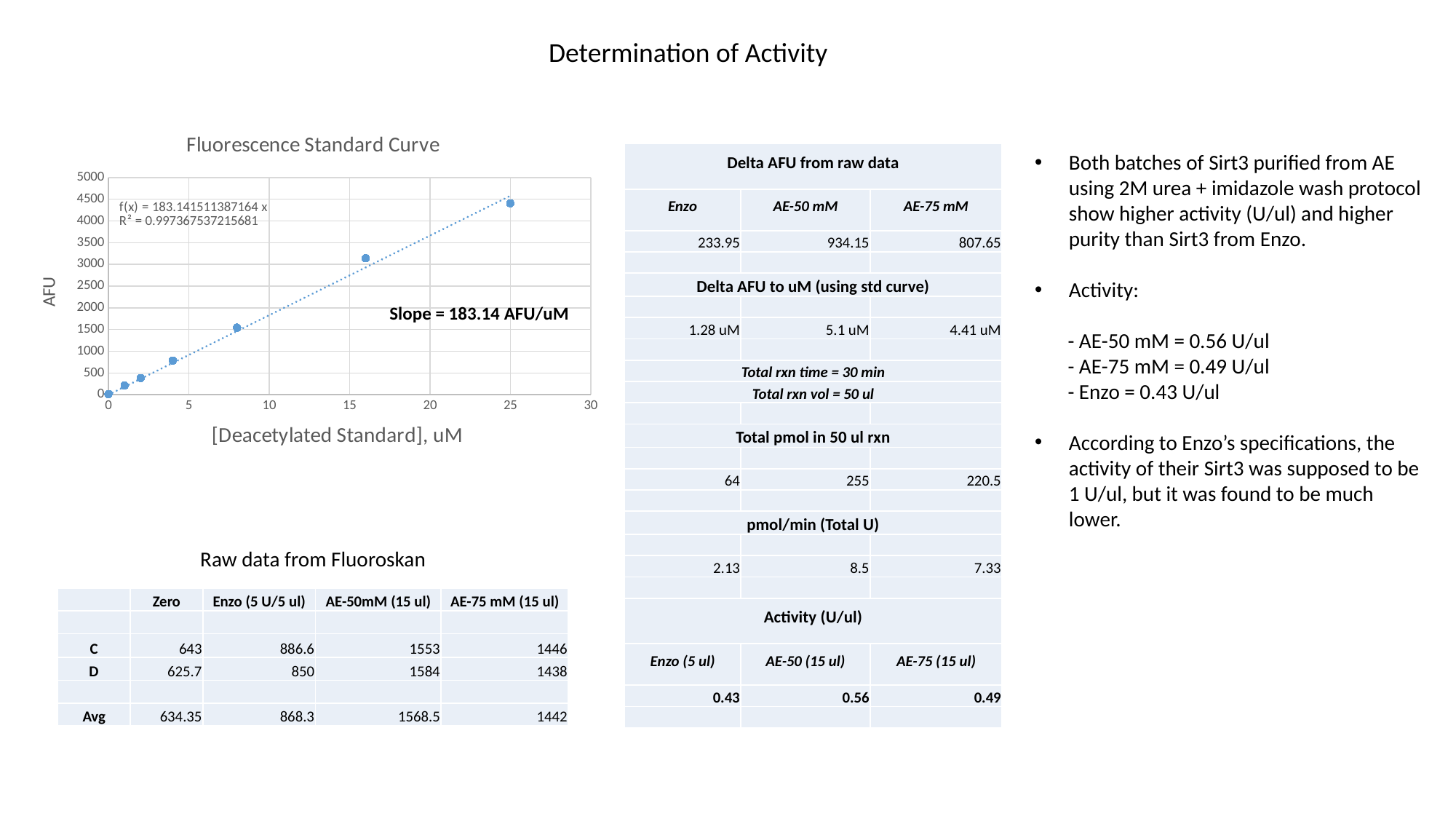
In the Fluorescence Standard Curve chart, is the AFU value for the point at 16 uM greater or less than 3000? greater What kind of chart is the Fluorescence Standard Curve? Scatter chart In the Fluorescence Standard Curve chart, which plotted point has the highest AFU value? The point at 25 uM In the Fluorescence Standard Curve chart, is the AFU value for the point at 4 uM greater or less than 1000? less What is the x-axis title of the Fluorescence Standard Curve chart? [Deacetylated Standard], uM In the Fluorescence Standard Curve chart, which has the larger AFU value: the point at 16 uM or the point at 8 uM? The point at 16 uM What slope is stated on the Fluorescence Standard Curve chart? 183.14 AFU/uM In the Fluorescence Standard Curve chart, do the AFU values rise or fall as the standard concentration increases? Rise In the Fluorescence Standard Curve chart, is the AFU value for the point at 8 uM greater or less than 2000? less What is the title of the chart on the slide? Fluorescence Standard Curve How many data points are plotted in the Fluorescence Standard Curve chart? 7